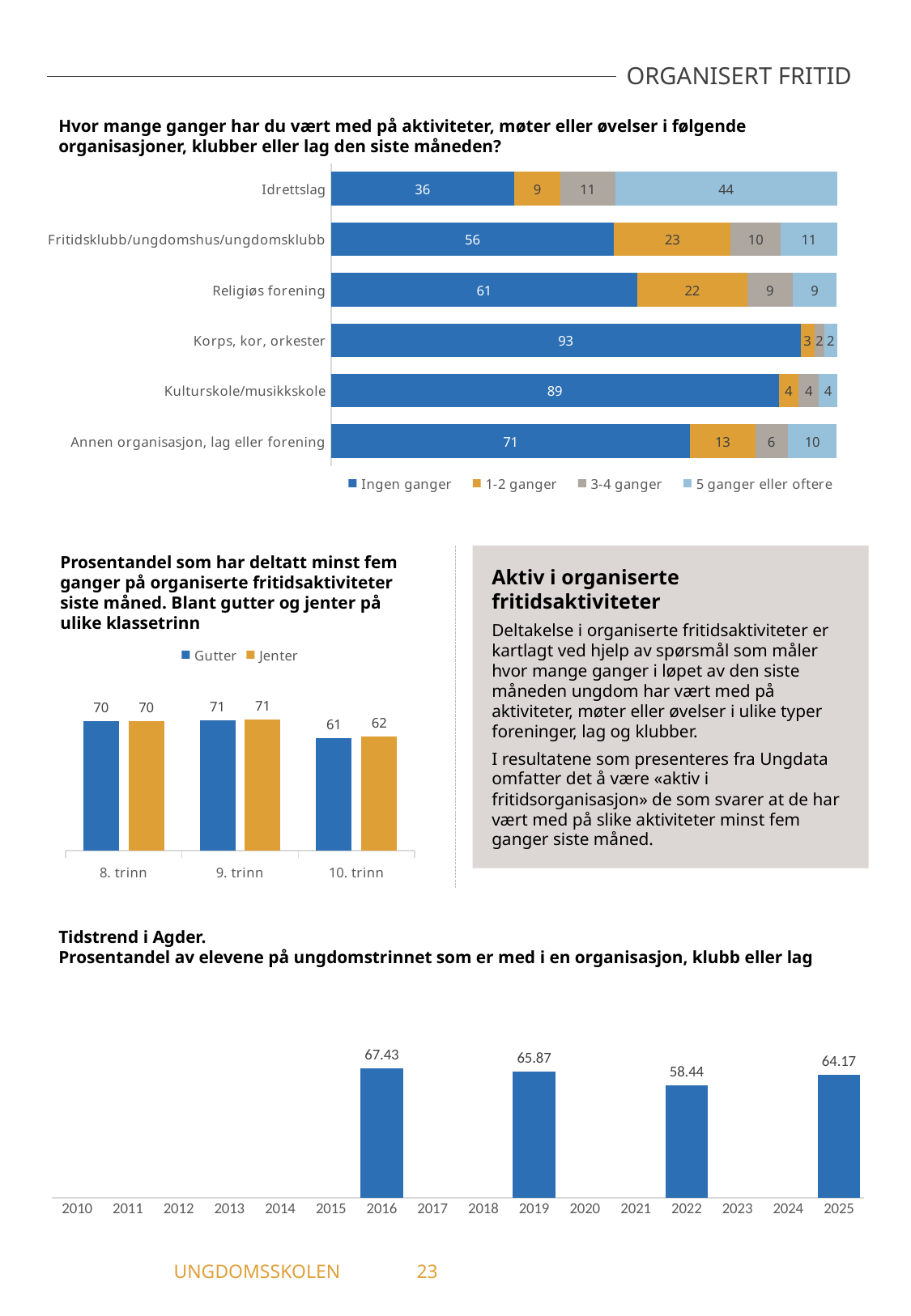
In the top chart, how many series does the legend list? 4 In the middle chart, which is larger: Gutter in 9. trinn or Gutter in 10. trinn? Gutter in 9. trinn In the top chart (Hvor mange ganger har du vært med på aktiviteter...), what is the value for 'Ingen ganger' for Idrettslag? 36 In the middle chart (Prosentandel som har deltatt minst fem ganger...), what is the value for Jenter in 10. trinn? 62 In the top chart, what is the difference between the '1-2 ganger' values for Fritidsklubb/ungdomshus/ungdomsklubb and Religiøs forening? 1 In the middle chart, what kind of chart is shown? Bar chart In the top chart, which category has the highest value for 'Ingen ganger'? Korps, kor, orkester In the top chart, how many categories are shown? 6 In the top chart, what is the total of the stacked bar for Annen organisasjon, lag eller forening? 100 In the bottom chart (Tidstrend i Agder), which year has the lowest value? 2022 In the bottom chart (Tidstrend i Agder), what is the value for 2022? 58.44 In the top chart, what is the value for '5 ganger eller oftere' for Idrettslag? 44